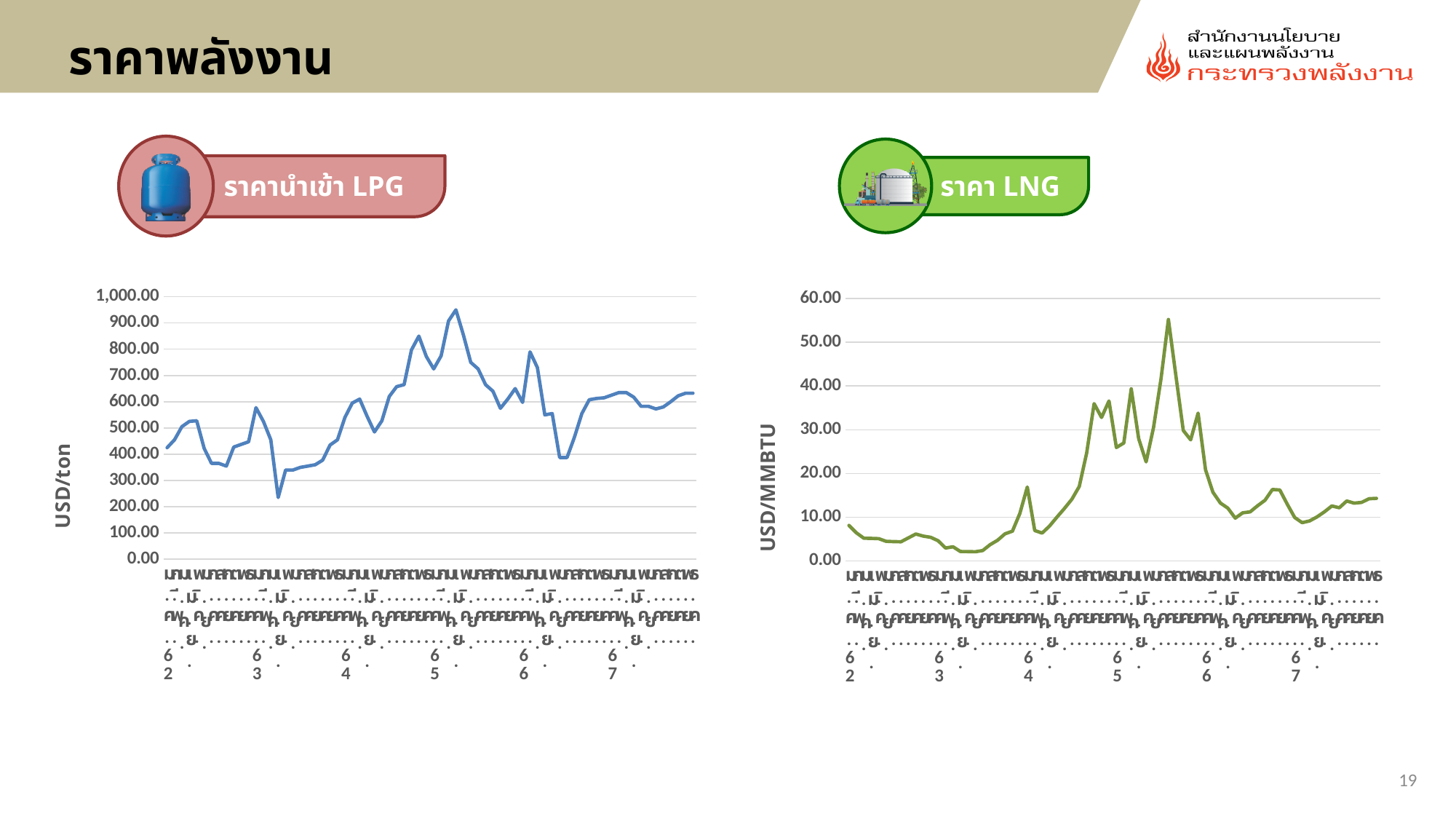
In the ราคานำเข้า LPG chart, is the lowest point of the line greater or less than 300.00? less In the ราคา LNG chart, is the lowest point of the line greater or less than 5.00? less What kind of chart is the ราคานำเข้า LPG chart on the left? line chart How many charts are shown on the slide? 2 In the ราคา LNG chart, what unit is shown on the vertical axis? USD/MMBTU In the ราคา LNG chart, does the line rise or fall from its peak to the end of the series? fall In the ราคา LNG chart, is the last value of the line greater or less than 20.00? less What kind of chart is the ราคา LNG chart on the right? line chart In the ราคานำเข้า LPG chart, what unit is shown on the vertical axis? USD/ton In the ราคานำเข้า LPG chart, which is larger, the first value of the line or the last value of the line? the last value